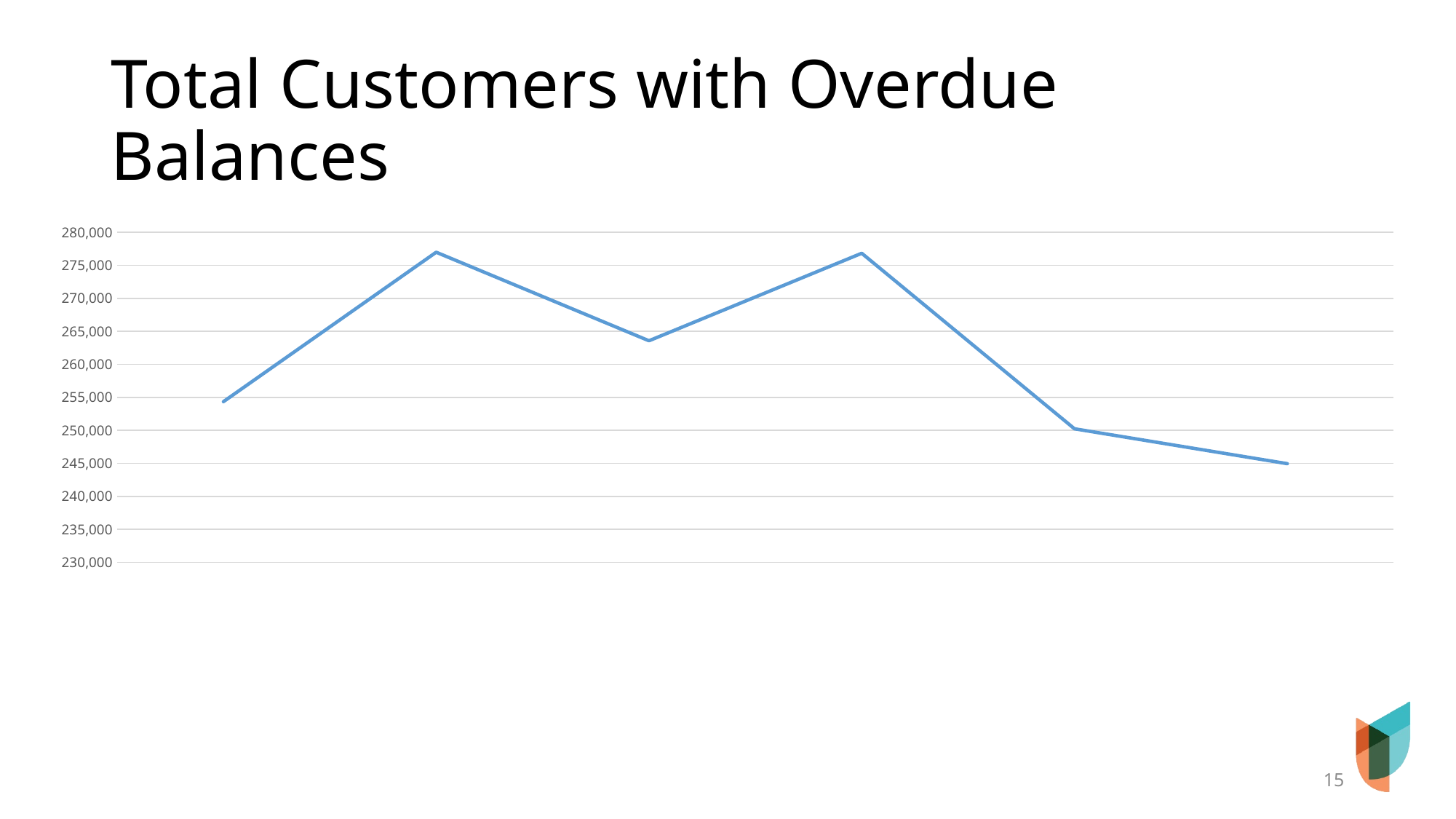
Is the value of the first point on the line greater or less than 260,000? less Is the value of the last point on the line greater or less than 250,000? less Does the line end higher or lower than it starts? lower What kind of chart is shown on the slide? line chart Is the value of the second point on the line greater or less than 275,000? greater What is the title of the chart on the slide? Total Customers with Overdue Balances Which is larger, the value of the second point or the value of the third point? the second point Which point on the line has the lowest value, the first or the last? the last What is the highest value shown on the vertical axis? 280,000 How many data points are plotted on the line? 6